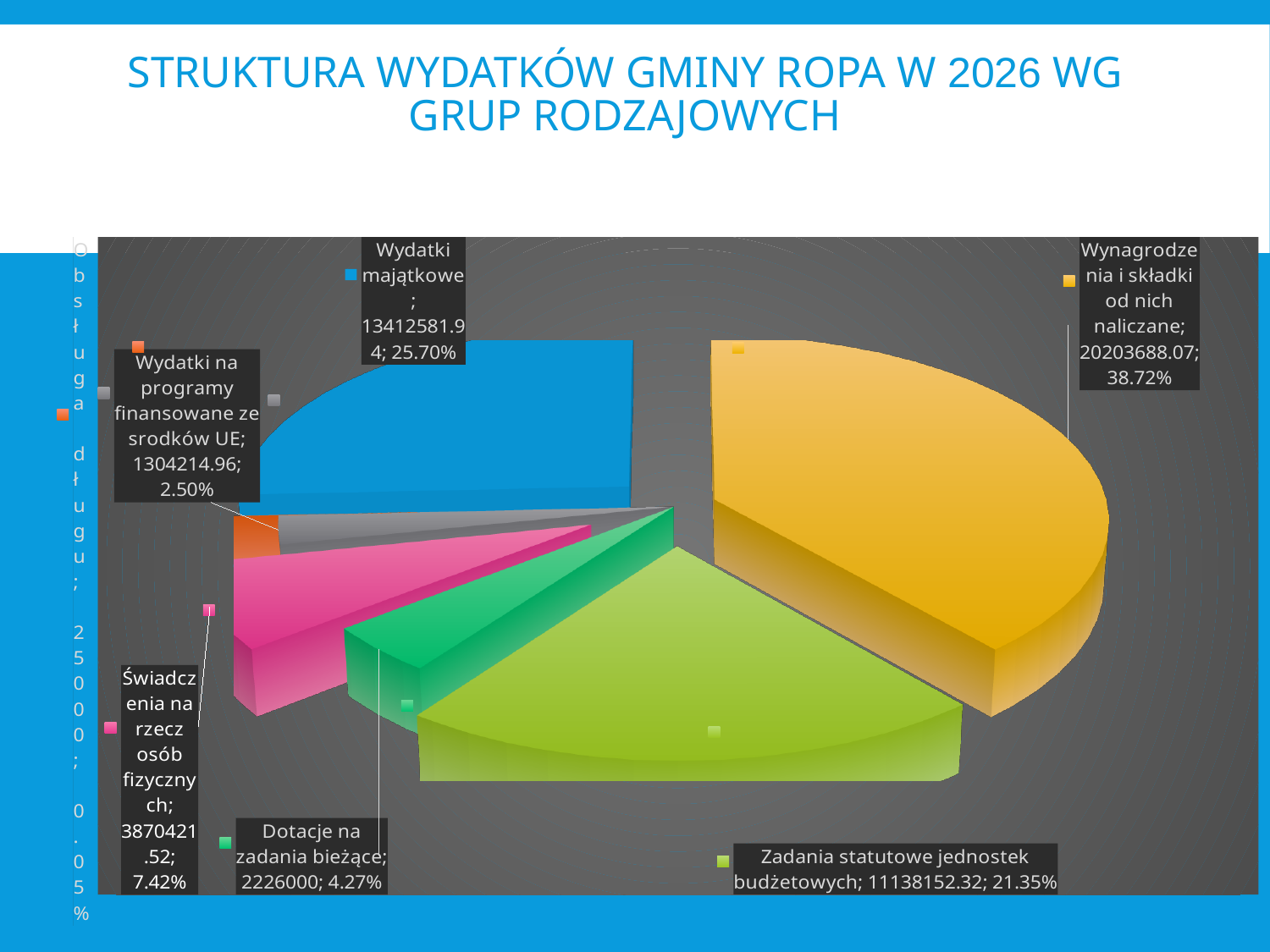
What kind of chart is shown on the slide? pie chart What percentage is shown for "Zadania statutowe jednostek budżetowych"? 21.35% What is the difference in percentage points between the shares of "Świadczenia na rzecz osób fizycznych" and "Dotacje na zadania bieżące"? 3.15 What percentage is shown for "Świadczenia na rzecz osób fizycznych"? 7.42% Which is larger, the share for "Wydatki majątkowe" or for "Zadania statutowe jednostek budżetowych"? Wydatki majątkowe What is the value shown for "Wydatki na programy finansowane ze srodków UE"? 1304214.96 What is the value shown for "Wydatki majątkowe"? 13412581.94 What is the difference in percentage points between the shares of "Wynagrodzenia i składki od nich naliczane" and "Wydatki majątkowe"? 13.02 What is the value shown for "Dotacje na zadania bieżące"? 2226000 What share of the pie does "Wynagrodzenia i składki od nich naliczane" represent? 38.72% What is the title of the chart on the slide? STRUKTURA WYDATKÓW GMINY ROPA W 2026 WG GRUP RODZAJOWYCH Which category has the largest share of the pie? Wynagrodzenia i składki od nich naliczane